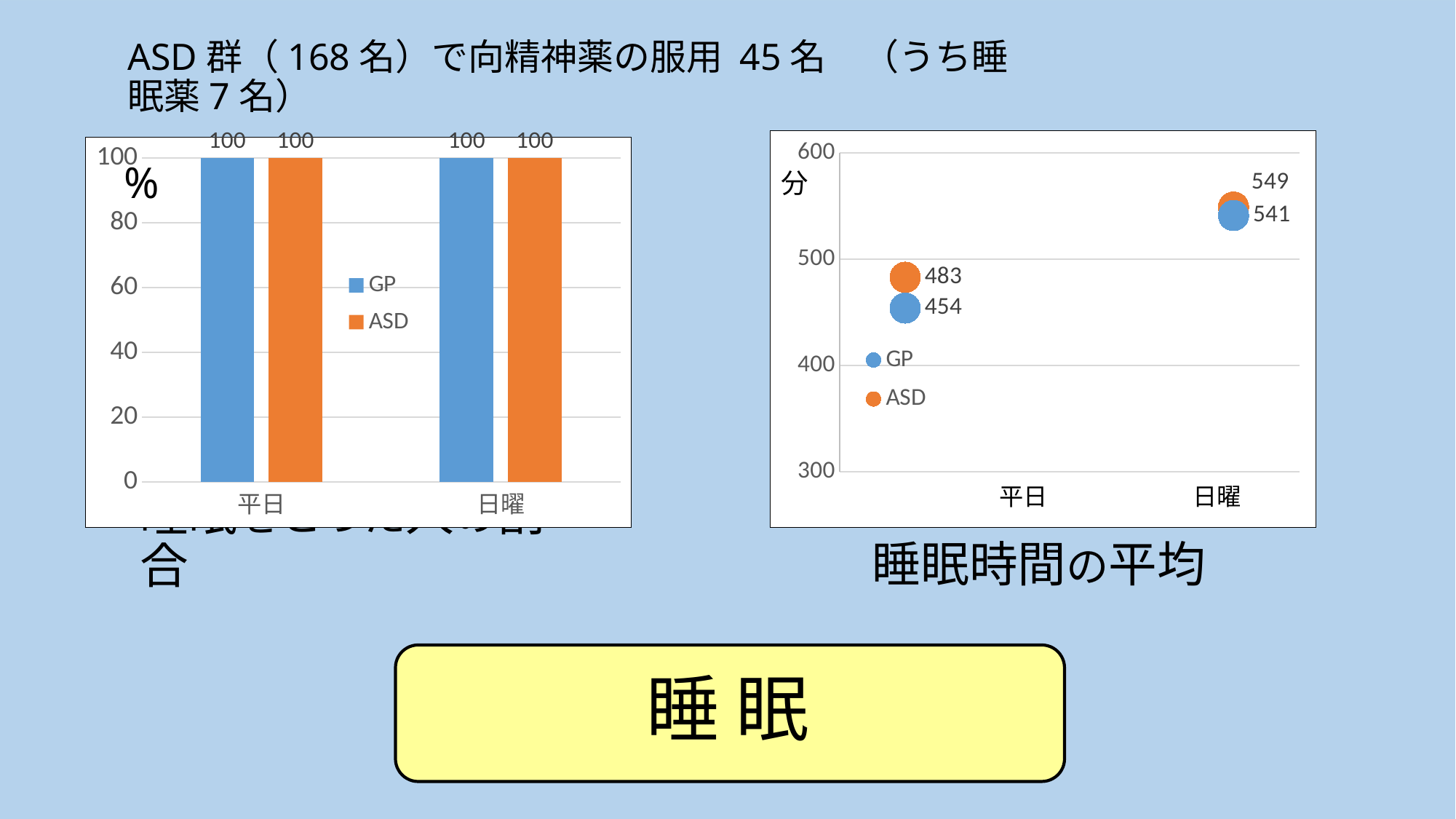
In the chart titled 睡眠時間の平均, is the value for GP on 平日 greater or less than 500? less How many categories are shown on the x axis of the chart on the left? 2 In the chart titled 睡眠時間の平均, what is the value for ASD on 平日? 483 In the chart on the left, what is the value for ASD on 日曜? 100 In the chart titled 睡眠時間の平均, what is the value for GP on 日曜? 541 How many series does the legend of the chart on the left list? 2 In the chart on the left, what is the value for GP on 平日? 100 In the chart titled 睡眠時間の平均, what colour represents ASD? orange In the chart titled 睡眠時間の平均, does the GP value rise or fall from 平日 to 日曜? rise What kind of chart is the chart on the left? bar chart In the chart titled 睡眠時間の平均, which is larger on 平日, GP or ASD? ASD In the chart titled 睡眠時間の平均, what is the difference between ASD and GP on 平日? 29